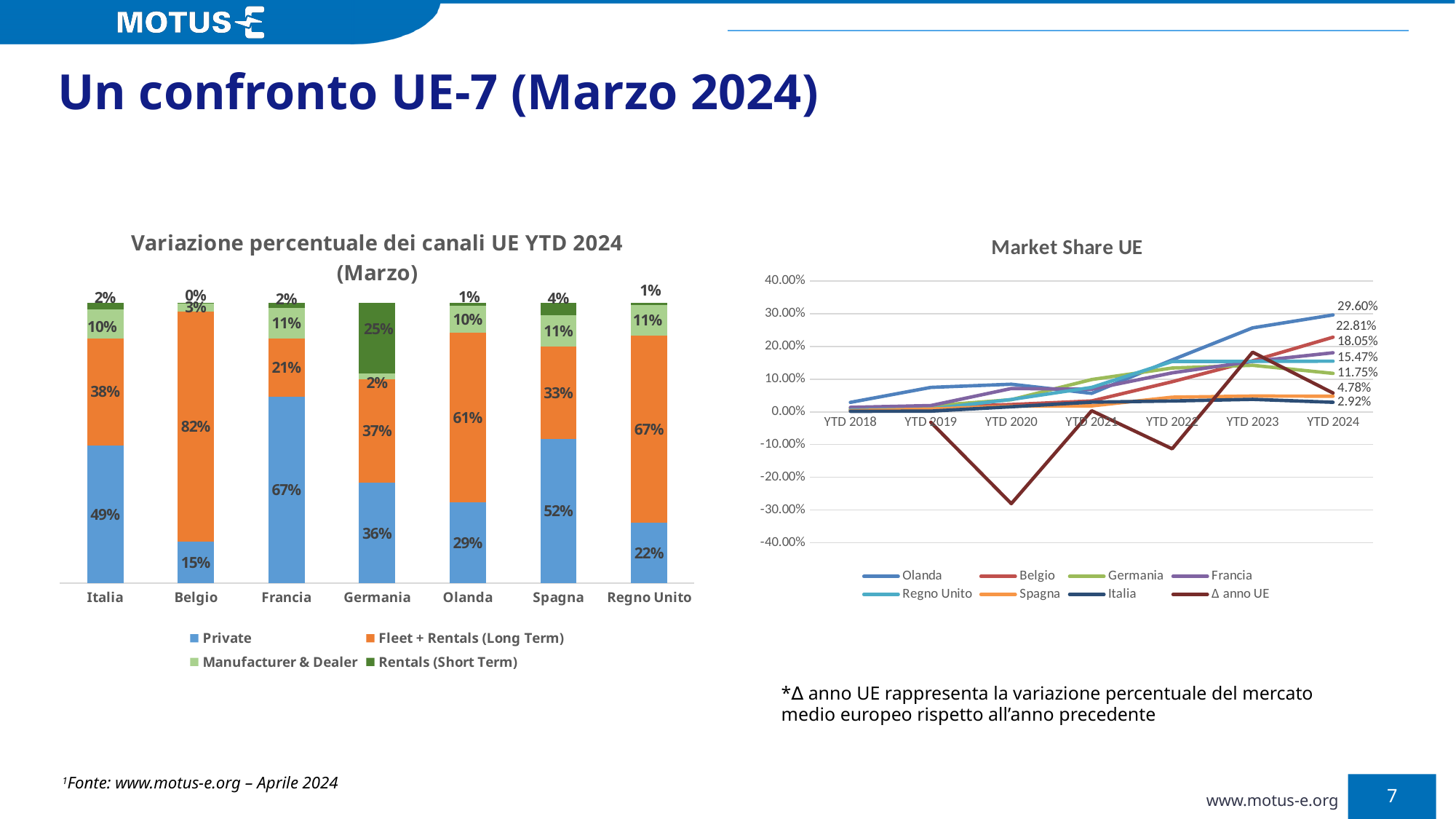
In the 'Variazione percentuale dei canali UE YTD 2024 (Marzo)' chart, which country has the lowest Private share? Belgio What kind of chart is 'Market Share UE'? Line chart In the 'Variazione percentuale dei canali UE YTD 2024 (Marzo)' chart, what is the Rentals (Short Term) share for Germania? 25% In the 'Variazione percentuale dei canali UE YTD 2024 (Marzo)' chart, which is larger: the Fleet + Rentals (Long Term) share of Regno Unito or of Olanda? Regno Unito In the 'Variazione percentuale dei canali UE YTD 2024 (Marzo)' chart, what is the difference between the Fleet + Rentals (Long Term) share of Olanda and that of Spagna? 28 percentage points In the 'Market Share UE' chart, what is the value for Olanda at YTD 2024? 29.60% How many countries are shown in the 'Variazione percentuale dei canali UE YTD 2024 (Marzo)' chart? 7 In the 'Variazione percentuale dei canali UE YTD 2024 (Marzo)' chart, what is the Private share for Italia? 49% In the 'Variazione percentuale dei canali UE YTD 2024 (Marzo)' chart, which country has the highest Private share? Francia How many series does the legend of the 'Market Share UE' chart list? 8 In the 'Variazione percentuale dei canali UE YTD 2024 (Marzo)' chart, what is the Fleet + Rentals (Long Term) share for Belgio? 82% What kind of chart is 'Variazione percentuale dei canali UE YTD 2024 (Marzo)'? Bar chart